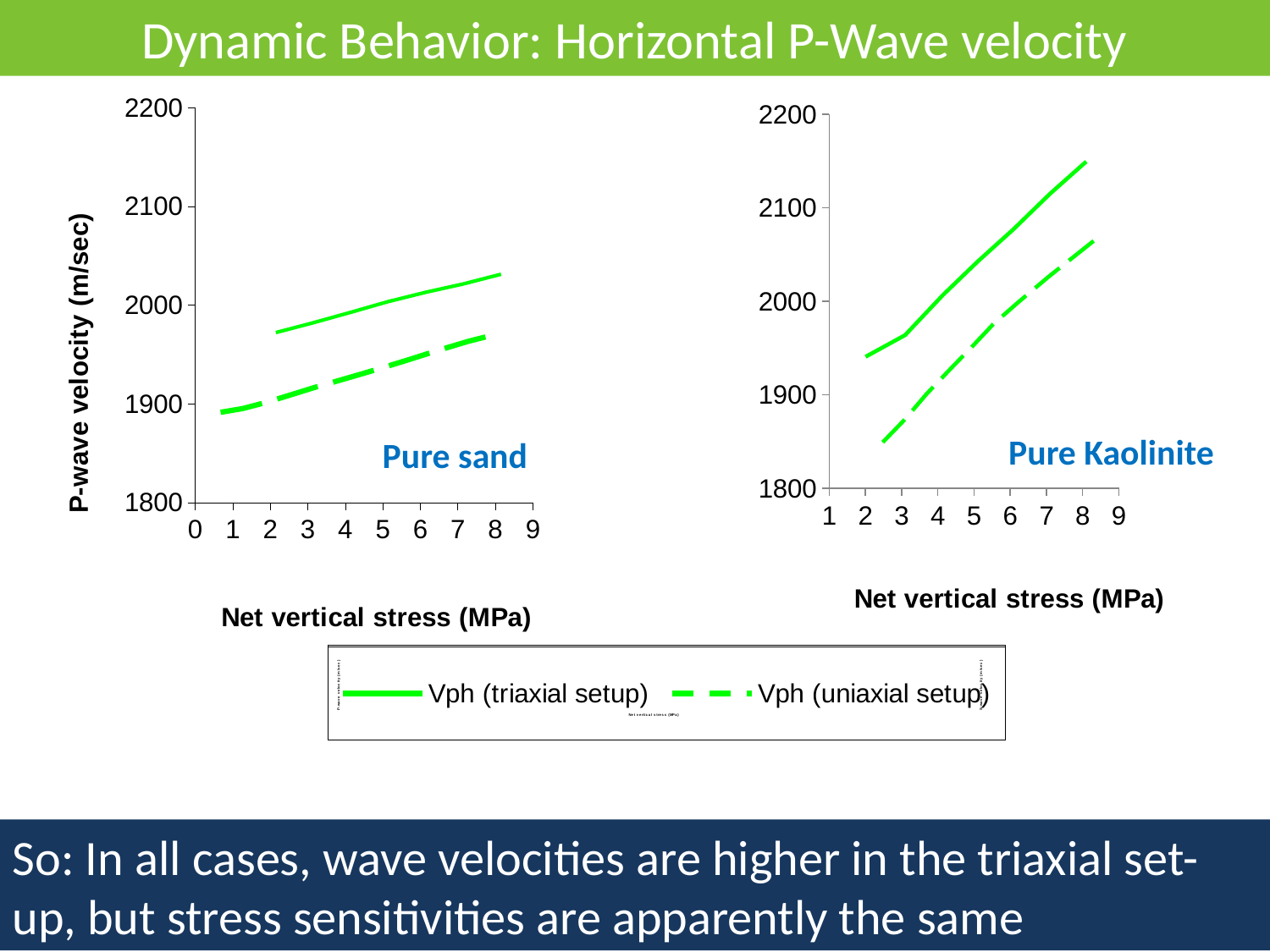
In the Pure sand chart, does the Vph (triaxial setup) line rise or fall as net vertical stress increases? Rises In the Pure Kaolinite chart, which series has the lower P-wave velocity at 2 MPa: Vph (triaxial setup) or Vph (uniaxial setup)? Vph (uniaxial setup) How many series does the legend list? 2 In the Pure Kaolinite chart, is the Vph (triaxial setup) value at 8 MPa greater or less than 2100? greater In the Pure sand chart, is the Vph (triaxial setup) value at 8 MPa greater or less than 2000? greater In the Pure sand chart, is the Vph (uniaxial setup) value at 8 MPa greater or less than 2000? less What is the x-axis title of the Pure Kaolinite chart? Net vertical stress (MPa) What is the y-axis title of the Pure sand chart? P-wave velocity (m/sec) In the Pure Kaolinite chart, does the Vph (uniaxial setup) line rise or fall as net vertical stress increases? Rises In the Pure sand chart, which series has the higher P-wave velocity at 8 MPa: Vph (triaxial setup) or Vph (uniaxial setup)? Vph (triaxial setup) What kind of chart is the Pure sand chart? Line chart